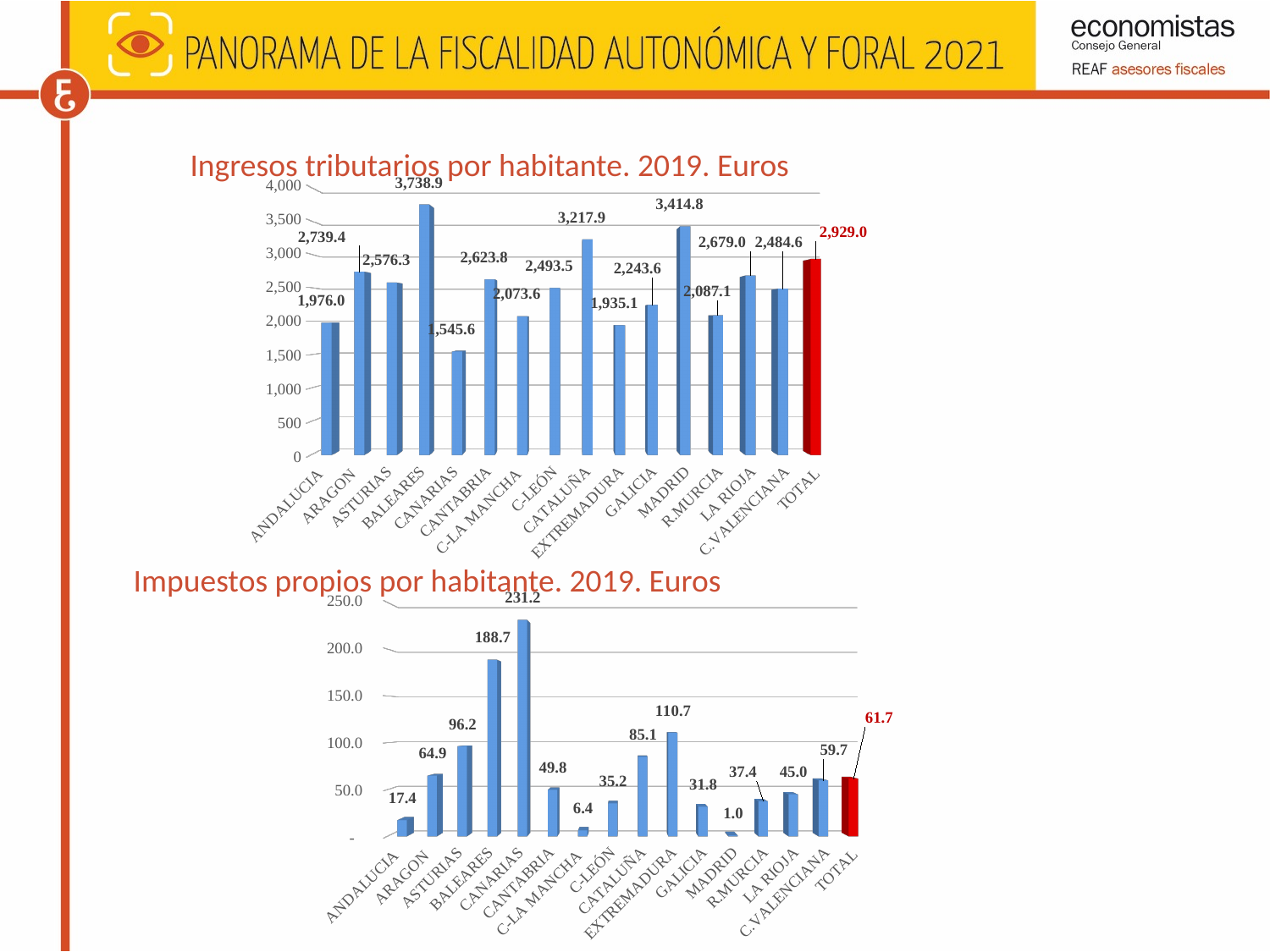
In the chart 'Ingresos tributarios por habitante. 2019. Euros', which is larger, ARAGON or LA RIOJA? ARAGON In the chart 'Ingresos tributarios por habitante. 2019. Euros', how many categories are shown on the x axis? 16 In the chart 'Impuestos propios por habitante. 2019. Euros', what is the value for CANARIAS? 231.2 In the chart 'Ingresos tributarios por habitante. 2019. Euros', what is the difference between MADRID and CATALUÑA? 196.9 In the chart 'Ingresos tributarios por habitante. 2019. Euros', what is the value for BALEARES? 3,738.9 What kind of chart is 'Impuestos propios por habitante. 2019. Euros'? Bar chart In the chart 'Ingresos tributarios por habitante. 2019. Euros', which category has the lowest value? CANARIAS In the chart 'Impuestos propios por habitante. 2019. Euros', what colour is the TOTAL bar? Red In the chart 'Impuestos propios por habitante. 2019. Euros', which is larger, ASTURIAS or CATALUÑA? ASTURIAS In the chart 'Impuestos propios por habitante. 2019. Euros', which category has the lowest value? MADRID In the chart 'Impuestos propios por habitante. 2019. Euros', what is the difference between BALEARES and EXTREMADURA? 78.0 In the chart 'Ingresos tributarios por habitante. 2019. Euros', what is the value for TOTAL? 2,929.0